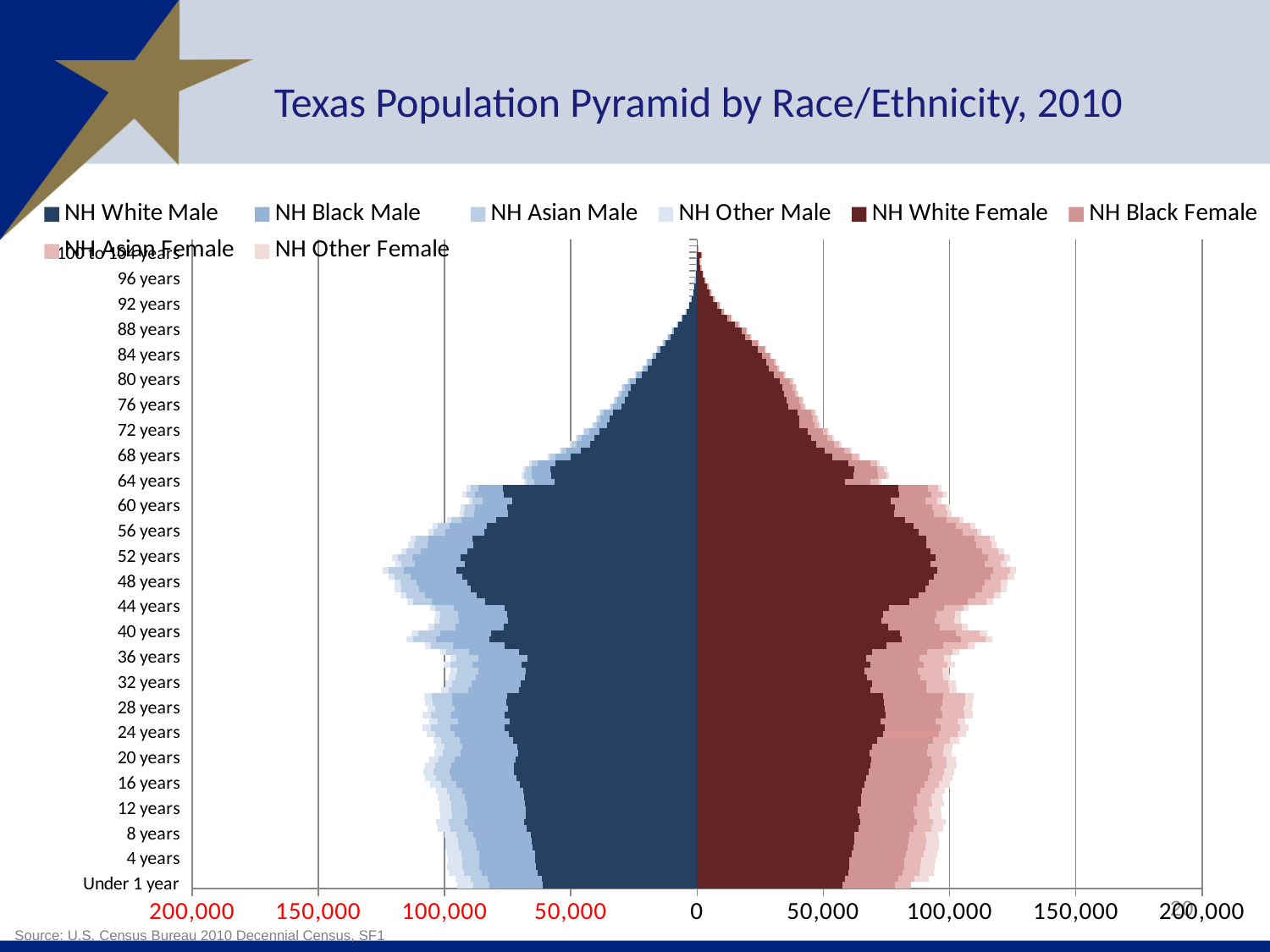
At 88 years, which side has the larger total bar, male or female? Female Is the total male population bar at 80 years greater or less than 50,000? less Is the total male population bar at 20 years greater or less than 150,000? less Which series is listed first in the legend? NH White Male What is the title of the chart? Texas Population Pyramid by Race/Ethnicity, 2010 From 64 years up to 100 to 104 years, do the bar lengths rise or fall as age increases? Fall Is the total female population bar at 80 years greater or less than 50,000? less What kind of chart is shown on the slide? Bar chart (population pyramid) Which age has the larger total female bar, 48 years or 80 years? 48 years How many series does the legend list? 8